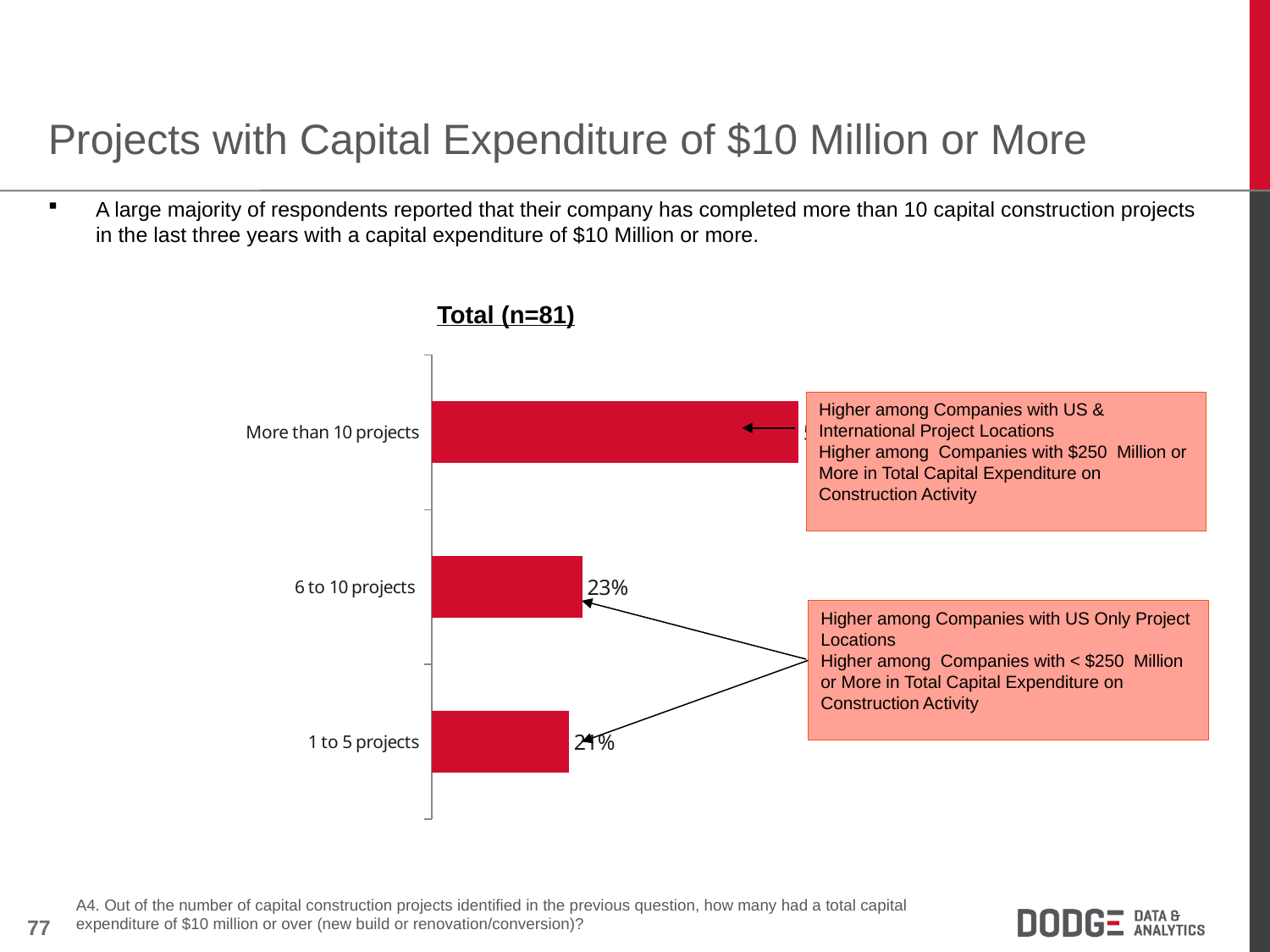
What is the value for 6 to 10 projects? 23% What is the title of the chart? Total (n=81) Which category has the highest value? More than 10 projects How many categories are shown in the chart? 3 What is the difference between the values for 6 to 10 projects and 1 to 5 projects? 2% Which is larger, the value for 6 to 10 projects or the value for 1 to 5 projects? 6 to 10 projects What is the value for 1 to 5 projects? 21% Which category is listed at the top of the chart? More than 10 projects Which category has the lowest value? 1 to 5 projects What kind of chart is shown on the slide? bar chart